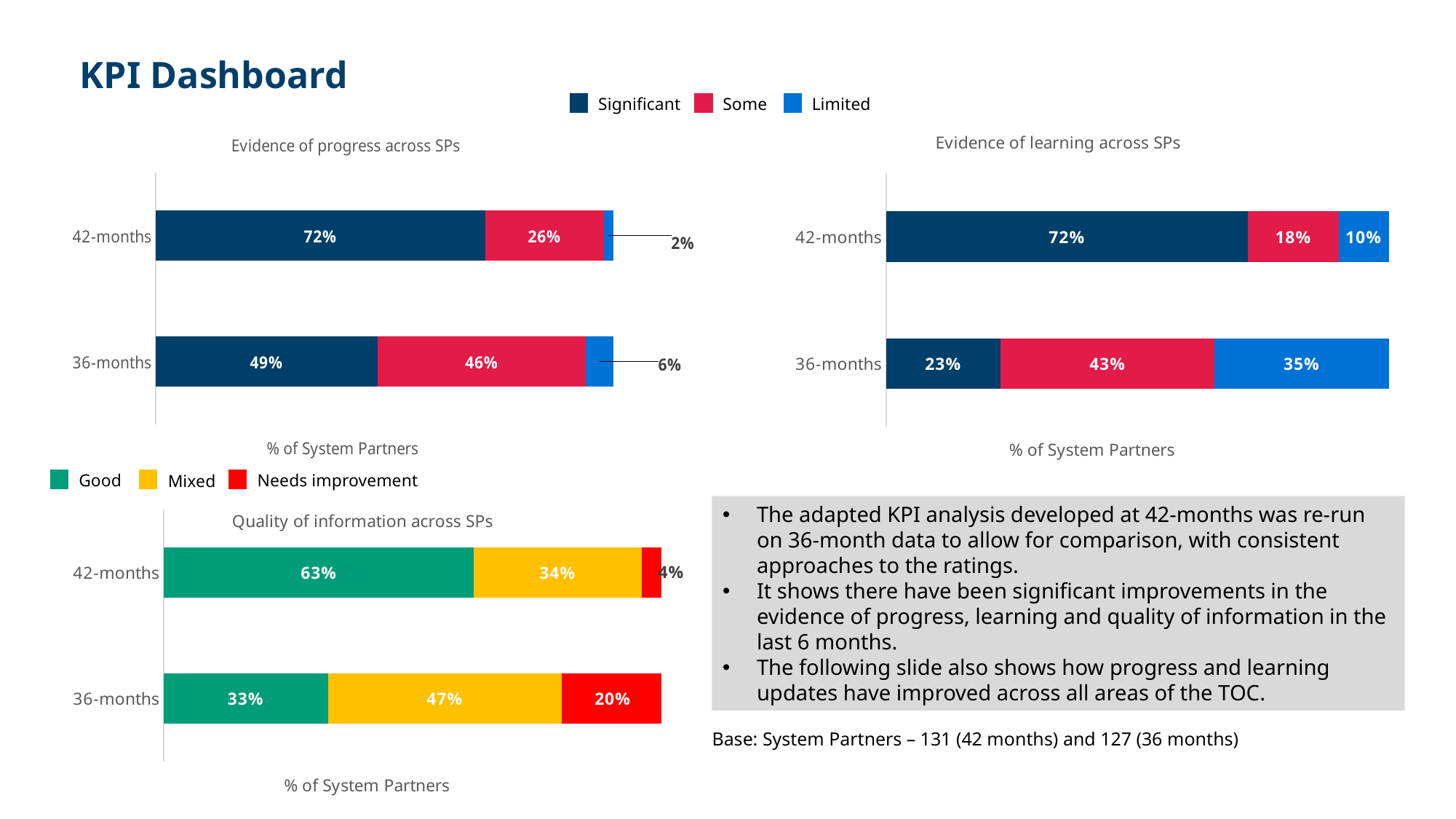
What kind of chart is 'Evidence of progress across SPs'? Stacked bar chart In the 'Evidence of learning across SPs' chart, which segment is largest for 36-months? Some In the 'Evidence of learning across SPs' chart, what is the difference between the Significant values for 42-months and 36-months? 49% How many series does the legend for the 'Quality of information across SPs' chart list? 3 In the 'Evidence of progress across SPs' chart, what is the Significant value for 42-months? 72% In the 'Evidence of progress across SPs' chart, which period has the smaller Limited value? 42-months In the 'Quality of information across SPs' chart, what is the Needs improvement value for 36-months? 20% How many categories are shown on the y axis of the 'Evidence of learning across SPs' chart? 2 What is the x-axis label of the 'Quality of information across SPs' chart? % of System Partners In the 'Evidence of progress across SPs' chart, what is the Some value for 36-months? 46% In the 'Quality of information across SPs' chart, which period has the larger Good value, 42-months or 36-months? 42-months In the 'Evidence of learning across SPs' chart, what is the Limited value for 36-months? 35%